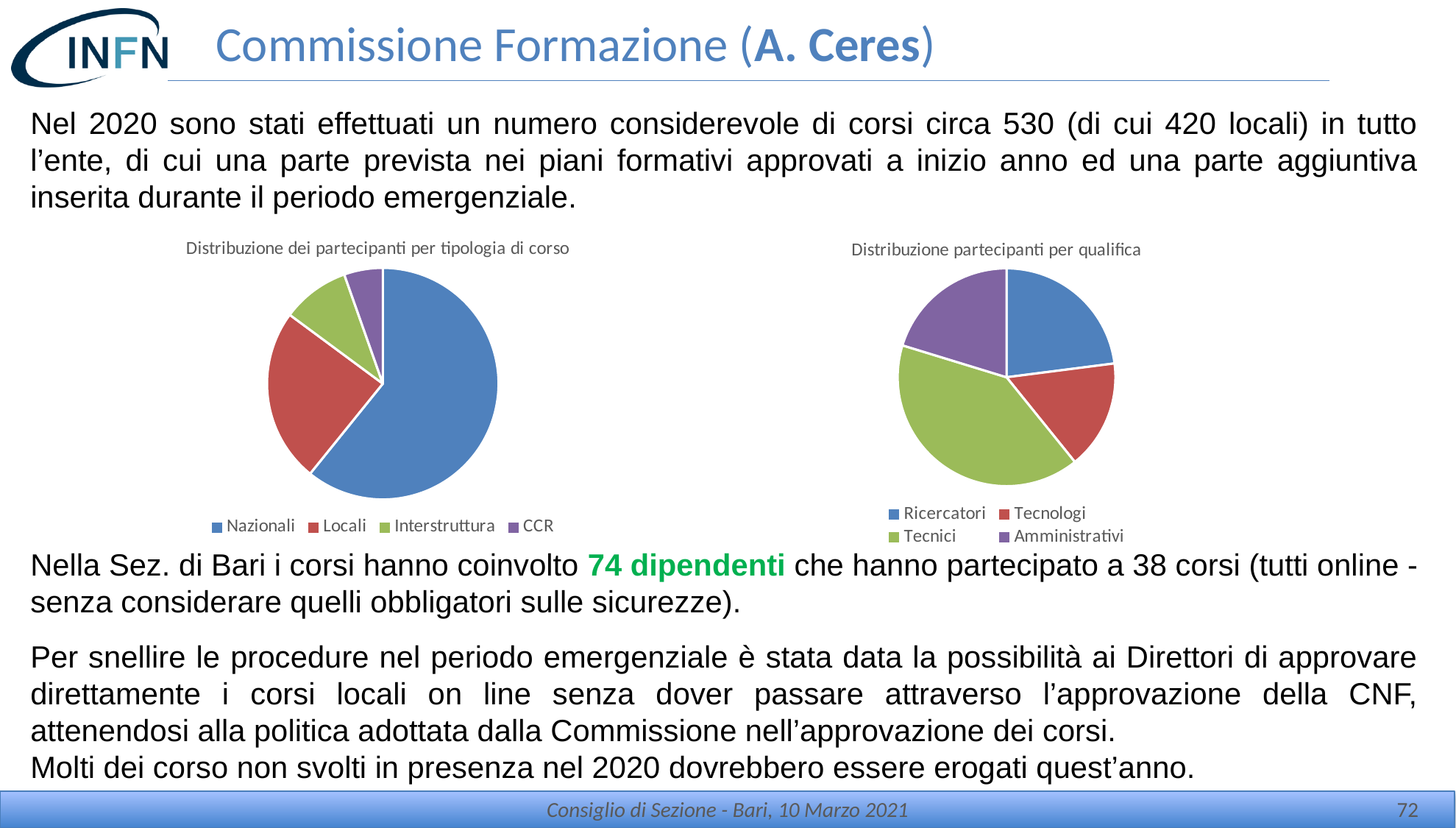
What kind of chart is the chart titled "Distribuzione dei partecipanti per tipologia di corso"? pie chart In the chart "Distribuzione partecipanti per qualifica", how many categories are listed in the legend? 4 In the chart "Distribuzione partecipanti per qualifica", which category has the largest slice? Tecnici In the chart "Distribuzione partecipanti per qualifica", which slice is larger, Tecnici or Amministrativi? Tecnici What is the title of the pie chart on the left of the slide? Distribuzione dei partecipanti per tipologia di corso What kind of chart is the chart titled "Distribuzione partecipanti per qualifica"? pie chart In the chart "Distribuzione partecipanti per qualifica", which colour represents Tecnici? green In the chart "Distribuzione dei partecipanti per tipologia di corso", which category has the smallest slice? CCR In the chart "Distribuzione dei partecipanti per tipologia di corso", which category has the largest slice? Nazionali In the chart "Distribuzione partecipanti per qualifica", which slice is larger, Ricercatori or Tecnici? Tecnici In the chart "Distribuzione dei partecipanti per tipologia di corso", how many slices does the pie have? 4 In the chart "Distribuzione dei partecipanti per tipologia di corso", which slice is larger, Locali or Interstruttura? Locali